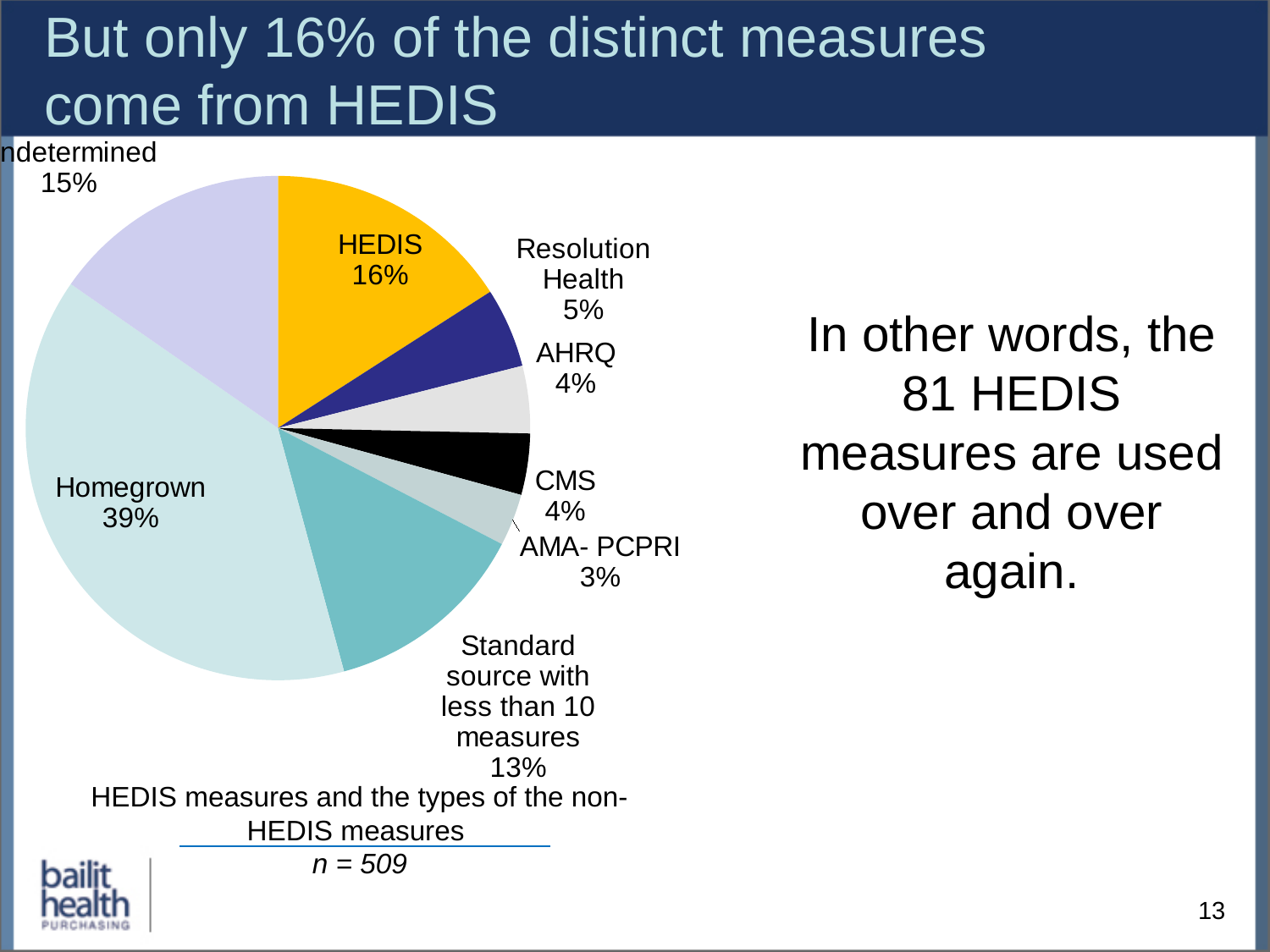
Which is larger, the Resolution Health slice or the AHRQ slice? Resolution Health Which slice of the pie chart is the largest? Homegrown How many slices does the pie chart have? 8 What sample size (n) is stated below the chart? n = 509 Which slice of the pie chart is the smallest? AMA- PCPRI What type of chart is shown on the slide? Pie chart What percentage of the pie is CMS? 4% How many percentage points larger is the Homegrown slice than the HEDIS slice? 23 percentage points What share of the pie chart is Homegrown? 39% What percentage does the Standard source with less than 10 measures slice represent? 13% What is the difference in percentage points between the HEDIS slice and the Standard source with less than 10 measures slice? 3 percentage points What percentage of the pie chart is HEDIS? 16%